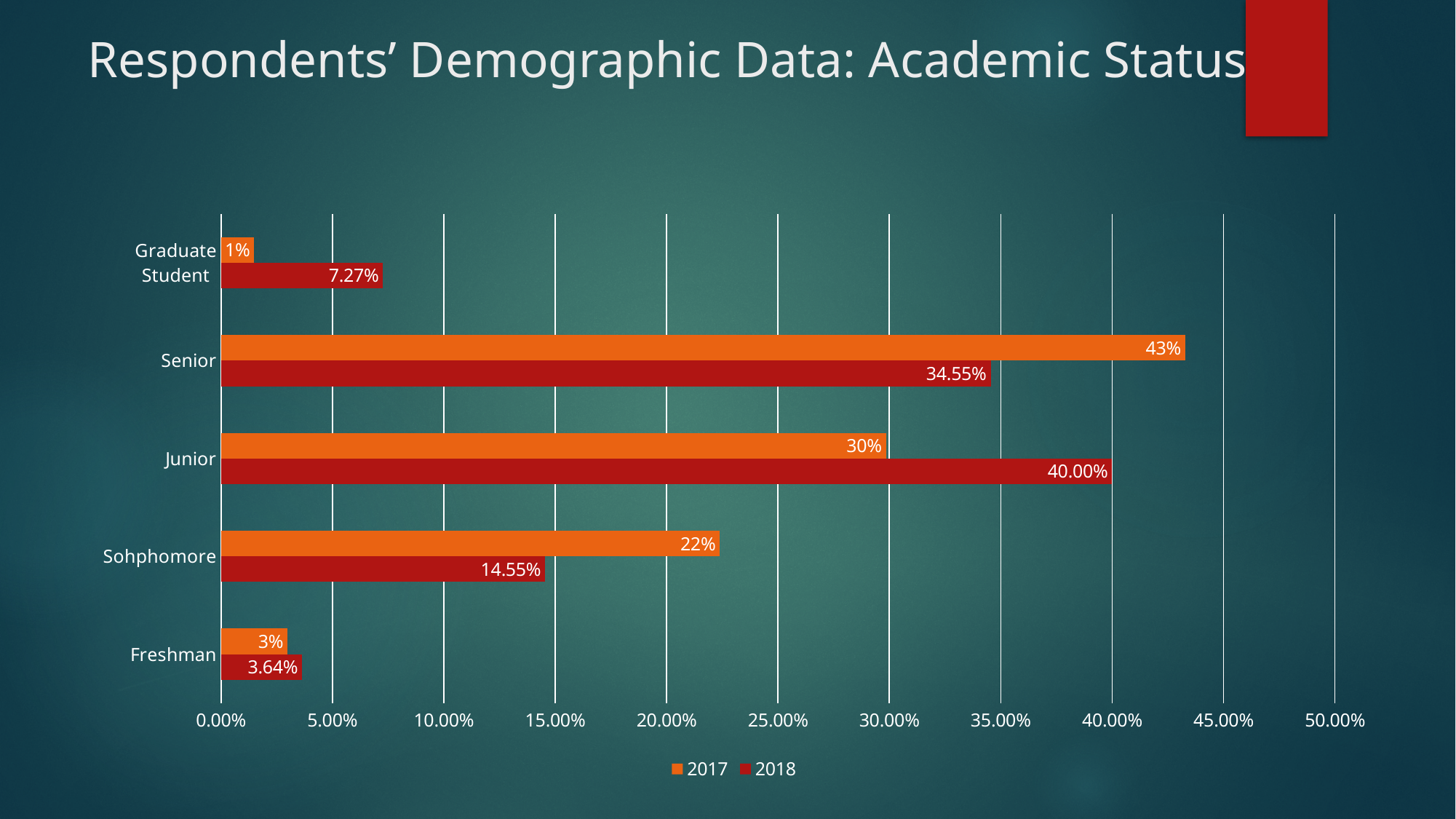
What is the 2017 value for Senior? 43% What is the title of the slide? Respondents' Demographic Data: Academic Status Which category has the lowest 2017 value? Graduate Student What is the 2017 value for Sohphomore? 22% What is the 2018 value for Graduate Student? 7.27% Which is larger for Freshman, the 2017 value or the 2018 value? 2018 How many categories are shown on the chart? 5 How many series does the legend list? 2 What kind of chart is shown on the slide? Bar chart What is the 2018 value for Junior? 40.00% Which category has the highest 2018 value? Junior What is the difference between the 2017 and 2018 values for Senior? 8.45%